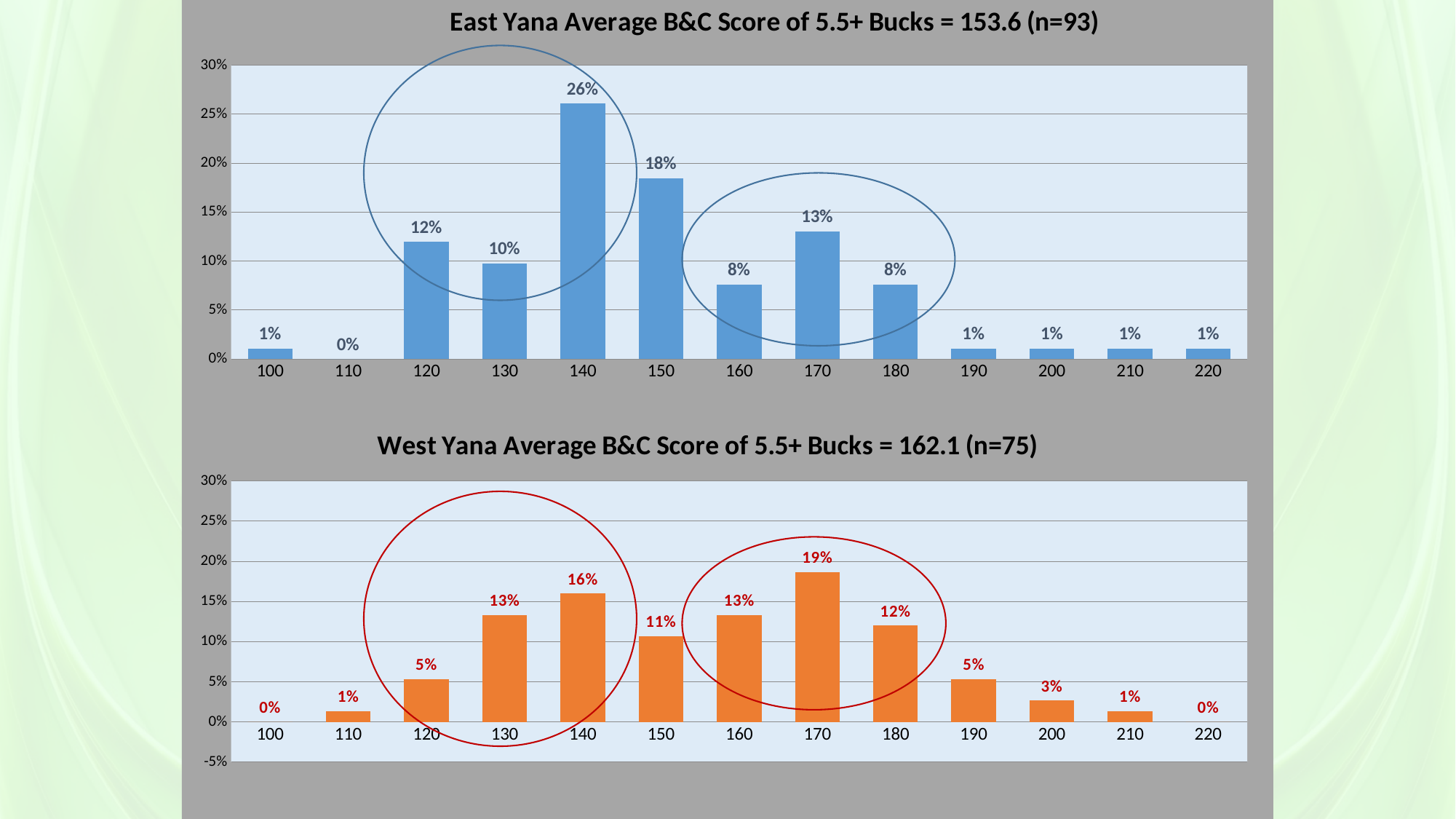
In the East Yana chart, how many categories are shown on the x axis? 13 What is the title of the top chart? East Yana Average B&C Score of 5.5+ Bucks = 153.6 (n=93) What type of chart is the West Yana chart? bar chart In the East Yana chart, what is the value for 170? 13% In the East Yana chart, which category has the lowest value? 110 In the West Yana chart, what is the value for 170? 19% In the West Yana chart, what is the difference between the values for 170 and 140? 3% In the West Yana chart, which category has the highest value? 170 In the East Yana chart, what is the difference between the values for 140 and 150? 8% In the East Yana chart, what is the value for 140? 26% In the West Yana chart, which is larger, the value for 130 or the value for 150? 130 In the East Yana chart, which category has the highest value? 140